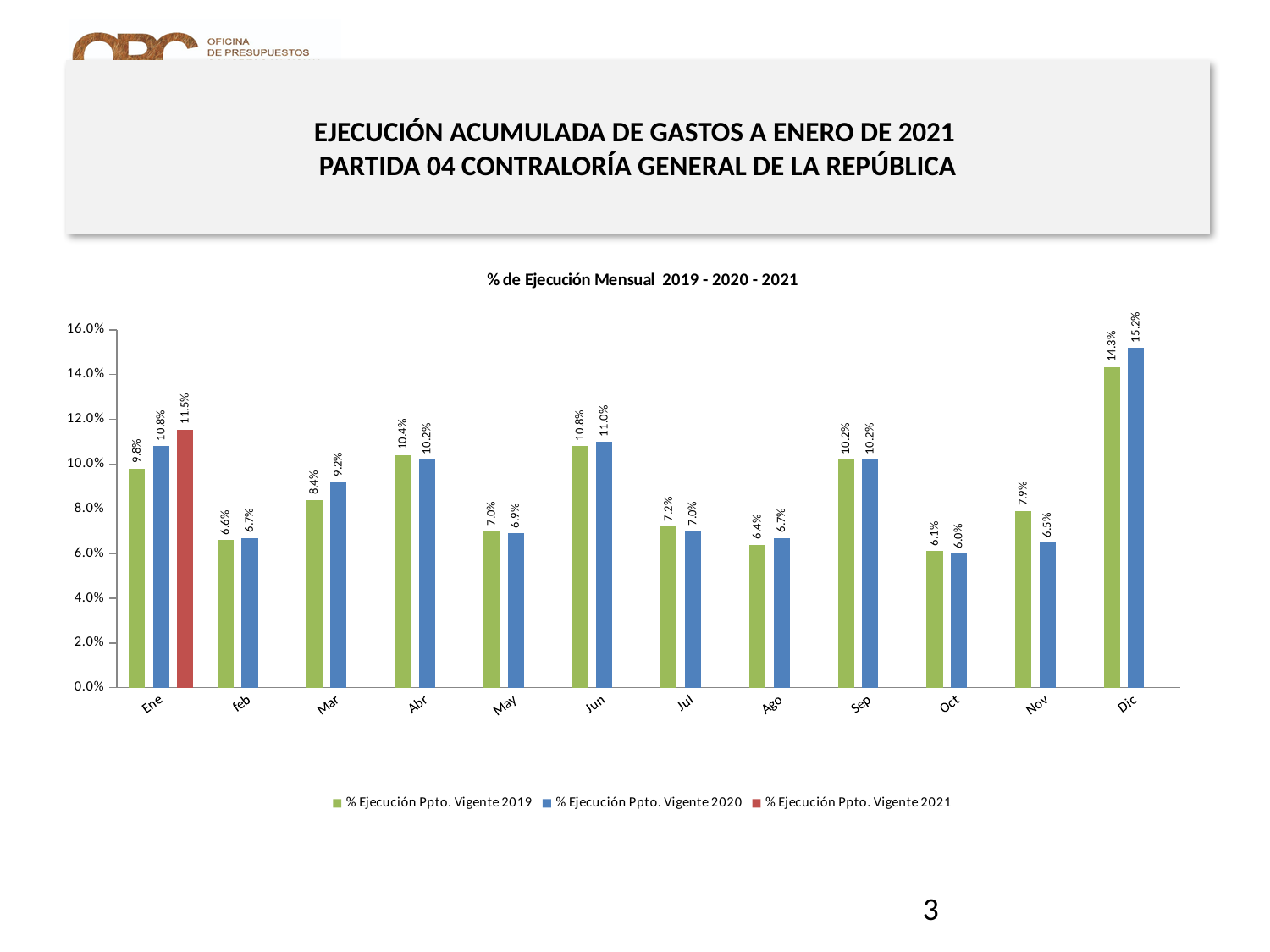
What is the value for % Ejecución Ppto. Vigente 2020 in Mar? 9.2% Which month has the highest value for % Ejecución Ppto. Vigente 2020? Dic What kind of chart is shown on the slide? Bar chart How many months are shown on the x axis? 12 Is the value for % Ejecución Ppto. Vigente 2020 in Dic greater or less than 14.0%? greater Which is larger in Jul: the 2019 value or the 2020 value? 2019 What is the title of the chart? % de Ejecución Mensual 2019 - 2020 - 2021 What is the difference between the 2020 and 2019 values in Ene? 1.0% How many series does the legend list? 3 Which month has the lowest value for % Ejecución Ppto. Vigente 2019? Oct What is the value for % Ejecución Ppto. Vigente 2019 in Dic? 14.3% What is the value for % Ejecución Ppto. Vigente 2021 in Ene? 11.5%